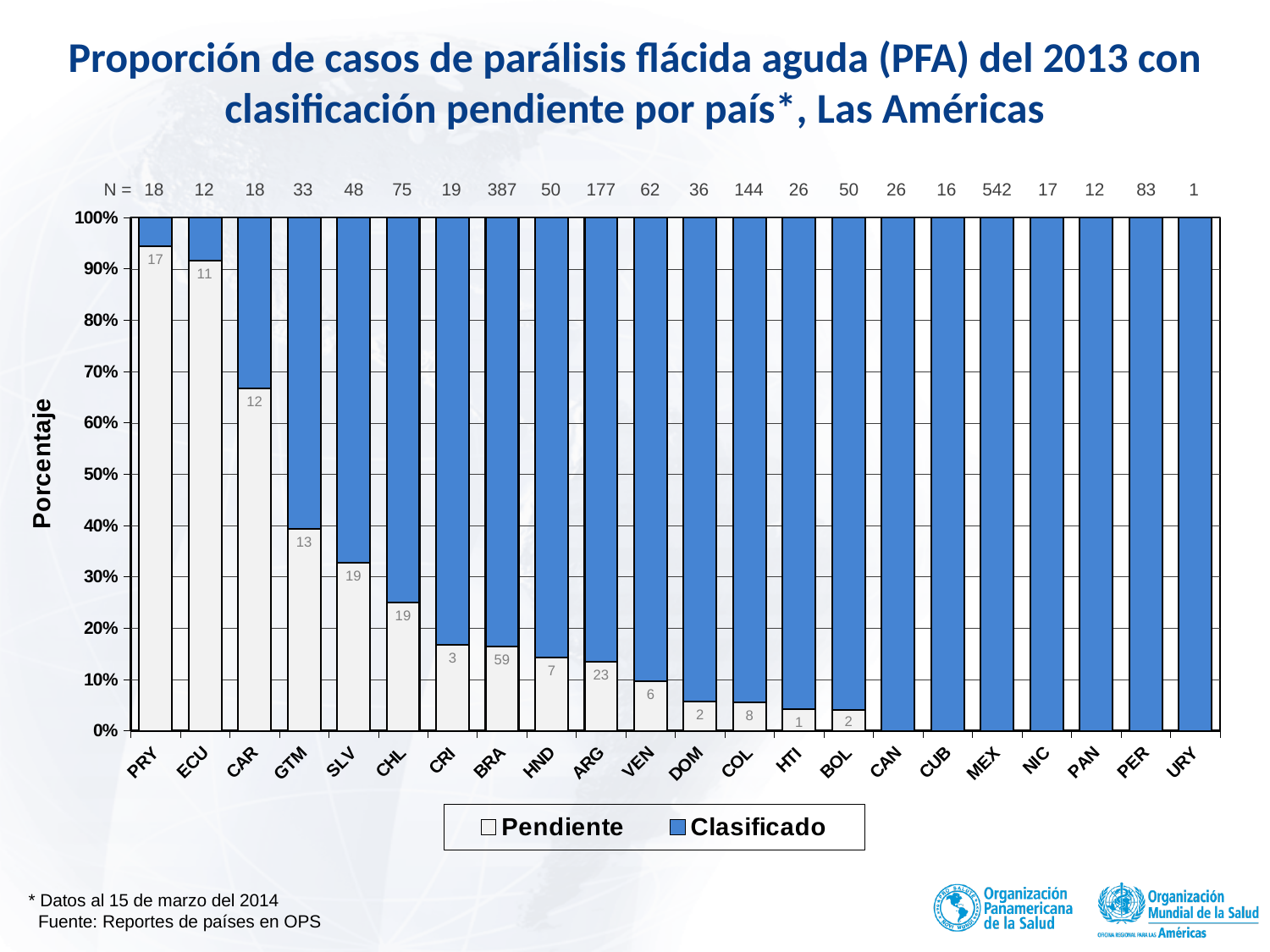
Which has the larger number printed on its Pendiente segment, PRY or ECU? PRY What is the difference between the Pendiente numbers printed for PRY (17) and ECU (11)? 6 What type of chart is shown on the slide? stacked bar chart Is the Pendiente share of the bar for PRY greater or less than 90%? greater Which country has the lowest N value printed above the bars? URY How many countries are shown along the x axis of the chart? 22 How many series does the legend list? 2 What number is printed on the Pendiente segment of the bar for BRA? 59 What are the two series named in the legend? Pendiente and Clasificado What is the N value printed above the bar for MEX? 542 What number is printed on the Pendiente segment of the bar for PRY? 17 Which country has the highest N value printed above the bars? MEX